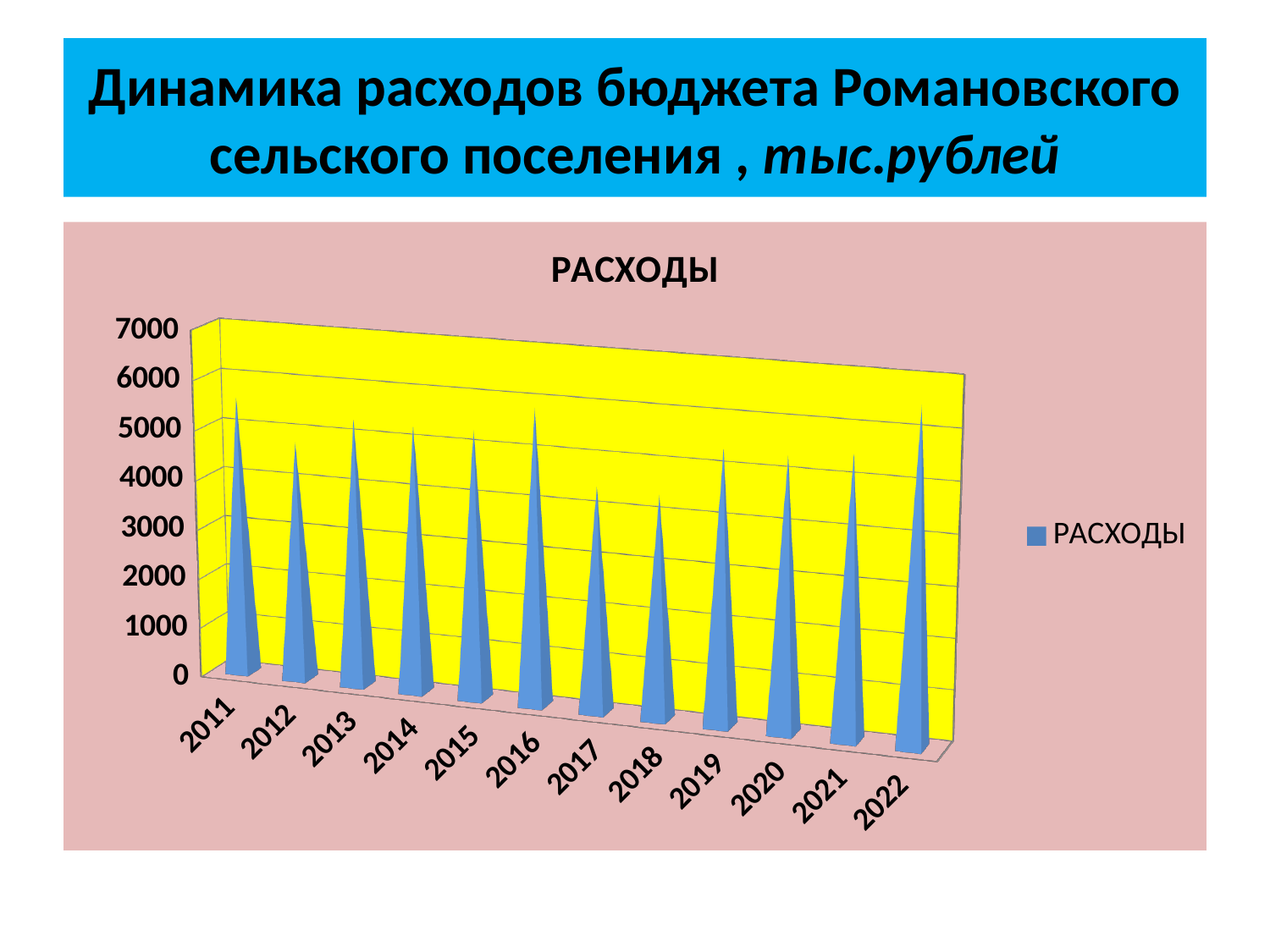
Is the value for 2012 greater or less than 4000? greater How many years are shown on the x axis of the chart? 12 What kind of chart is shown on the slide? bar chart Is the value for 2018 greater or less than 5000? less How many series does the legend list? 1 Is the value for 2011 greater or less than 5000? greater What is the first year shown on the x axis? 2011 What is the title of the chart? РАСХОДЫ Which is larger, the value for 2011 or the value for 2017? 2011 Which is larger, the value for 2016 or the value for 2018? 2016